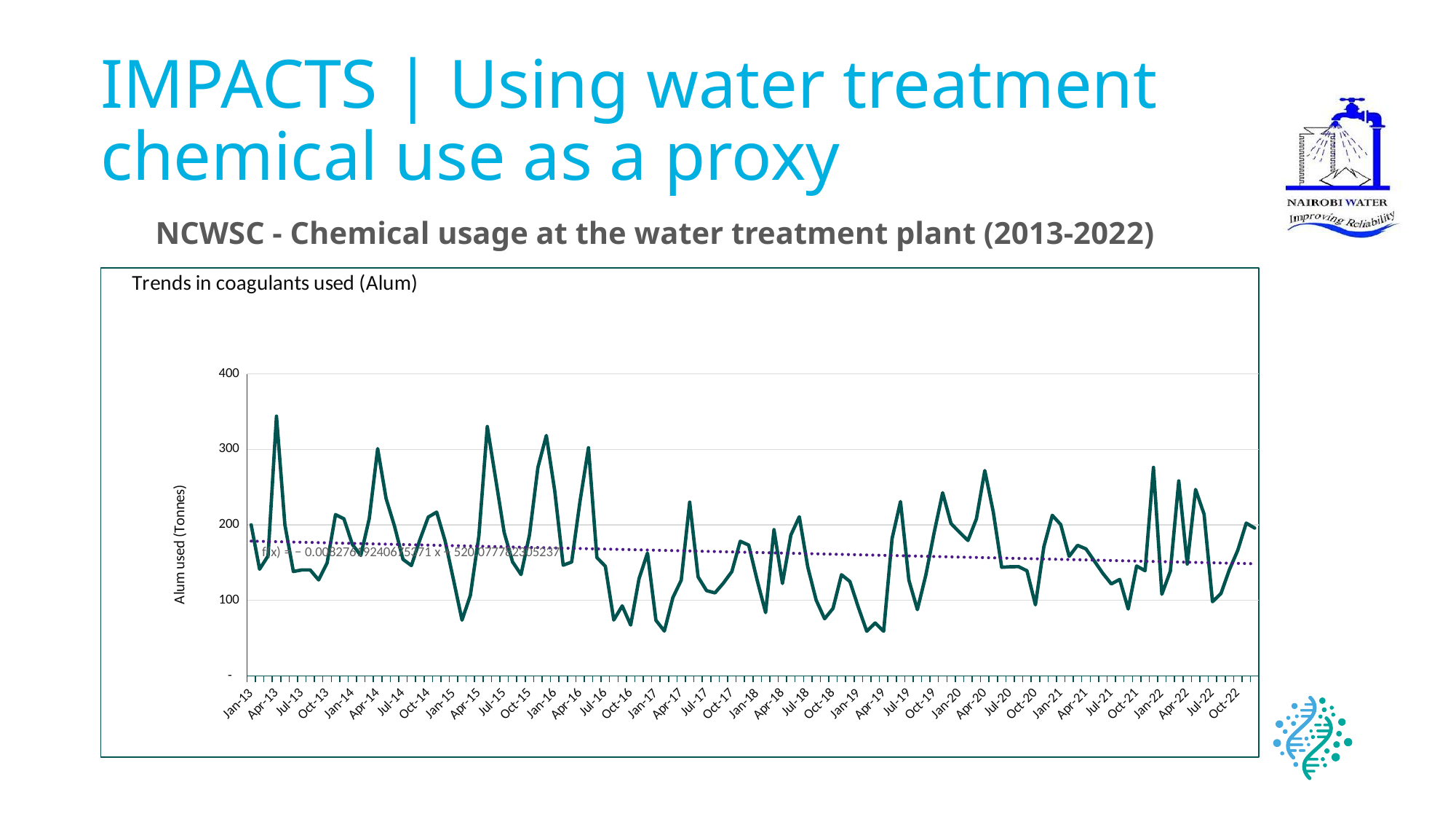
What kind of chart is shown on the slide? line chart Is the value for Jan-16 greater or less than 300? less Is the value for Apr-20 greater or less than 200? greater Which month has the highest alum usage on the chart? Apr-13 What is the title of the chart? Trends in coagulants used (Alum) Which is larger, the value for Apr-13 or the value for Jan-17? Apr-13 Is the value for Apr-13 greater or less than 300? greater What is the label on the y axis of the chart? Alum used (Tonnes) According to the dotted trend line, do alum usage values rise or fall from 2013 to 2022? fall